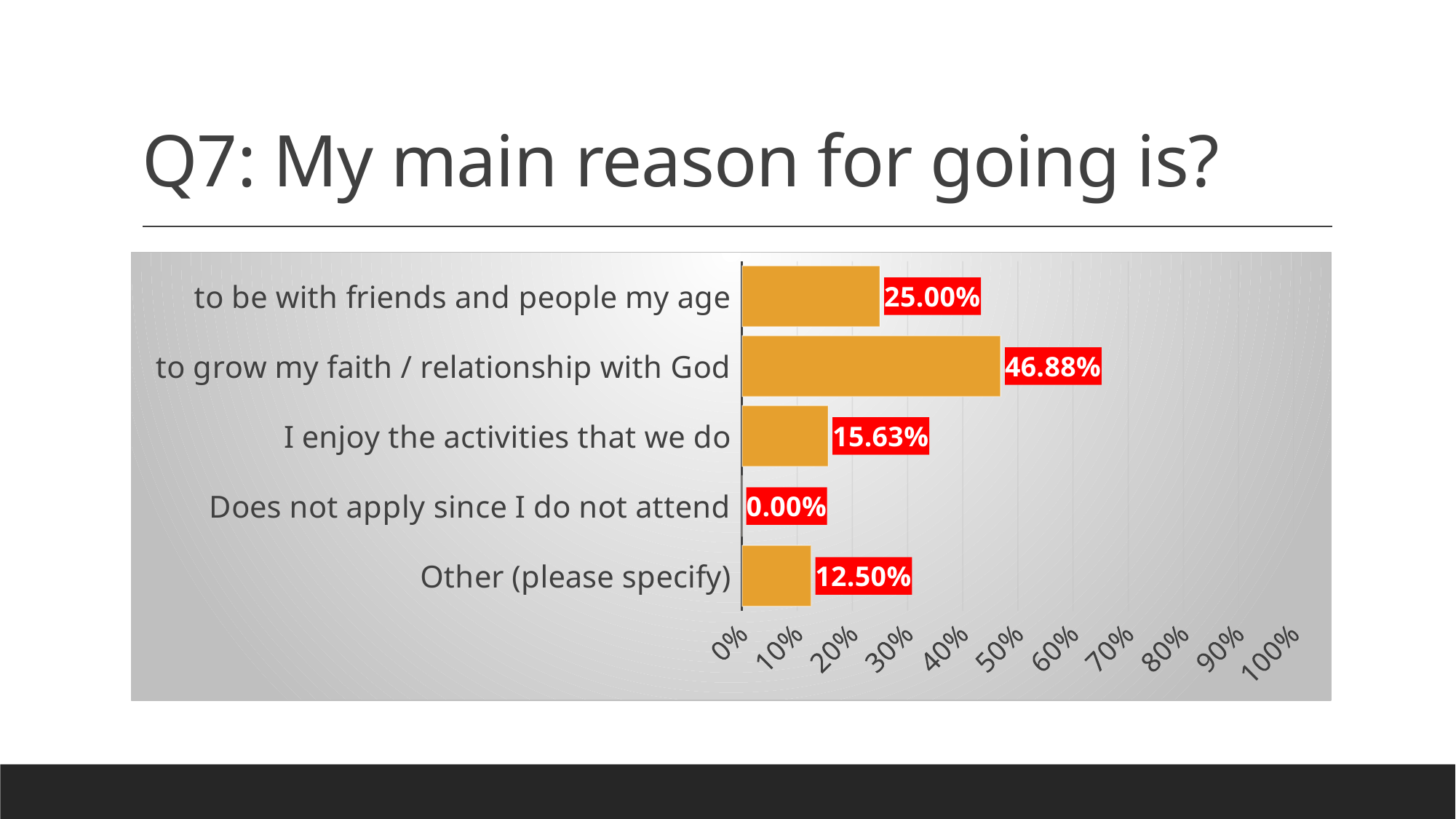
Which category has the lowest percentage? Does not apply since I do not attend Is the value for "to grow my faith / relationship with God" greater or less than 50%? less How many categories are shown in the chart? 5 What percentage is shown for "I enjoy the activities that we do"? 15.63% Which is larger: the value for "I enjoy the activities that we do" or the value for "Other (please specify)"? I enjoy the activities that we do What value is shown for "Other (please specify)"? 12.50% What is the value shown for "to grow my faith / relationship with God"? 46.88% What is the difference between the percentages for "to grow my faith / relationship with God" and "to be with friends and people my age"? 21.88% What is the title of the slide containing the chart? Q7: My main reason for going is? What kind of chart is shown on the slide? bar chart What percentage of respondents chose "to be with friends and people my age" as their main reason for going? 25.00% Which category has the highest percentage? to grow my faith / relationship with God